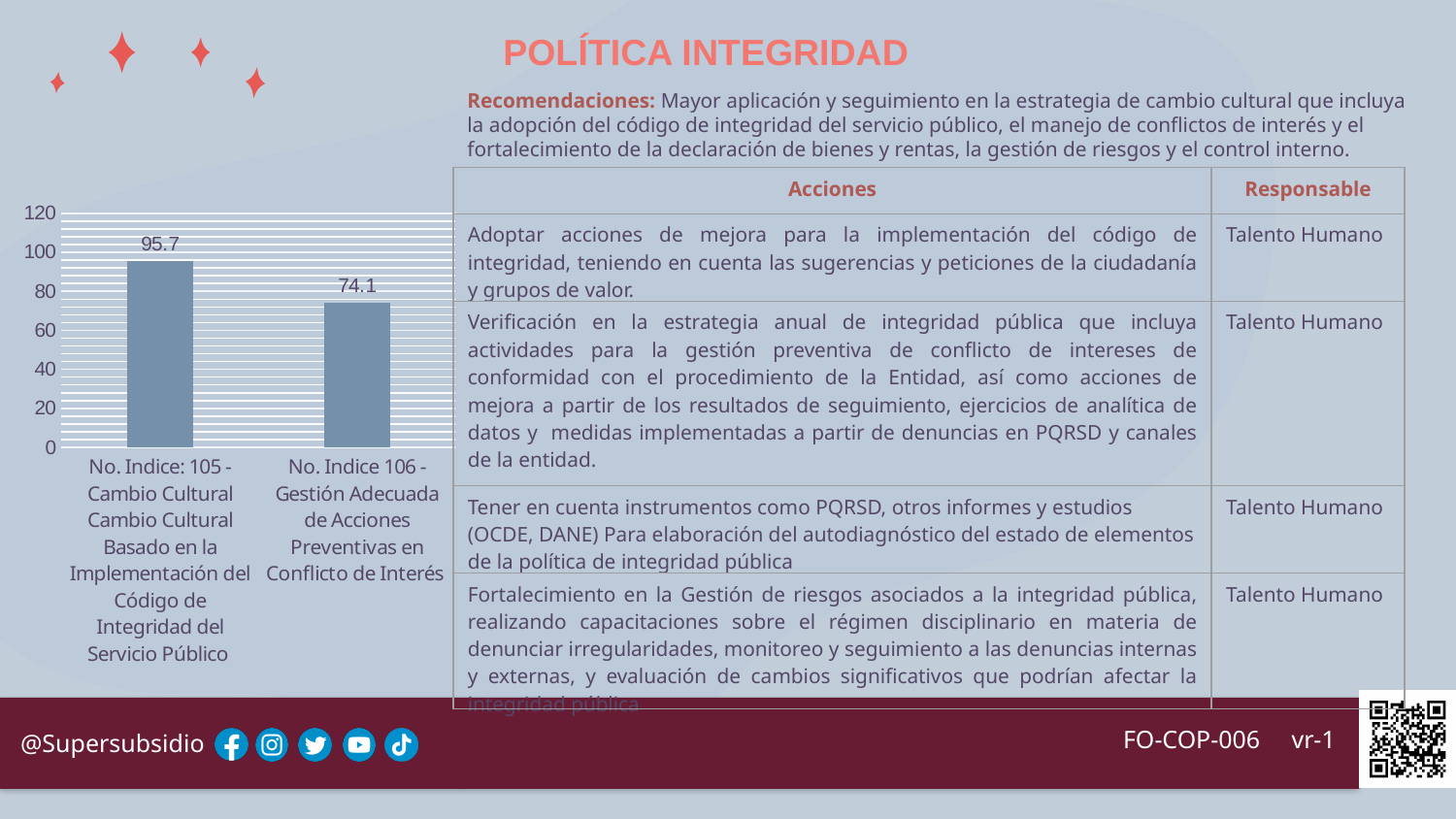
What is the difference between the values for No. Indice: 105 and No. Indice 106? 21.6 Which category has the lowest value? No. Indice 106 - Gestión Adecuada de Acciones Preventivas en Conflicto de Interés Is the value for No. Indice 106 - Gestión Adecuada de Acciones Preventivas en Conflicto de Interés greater or less than 80? less Which category has the highest value? No. Indice: 105 - Cambio Cultural Basado en la Implementación del Código de Integridad del Servicio Público What kind of chart is shown on the slide? bar chart How many categories are shown in the chart? 2 What is the value for No. Indice 106 - Gestión Adecuada de Acciones Preventivas en Conflicto de Interés? 74.1 Is the value for No. Indice: 105 greater or less than 80? greater Which is larger, the value for No. Indice: 105 or the value for No. Indice 106? No. Indice: 105 What is the value for No. Indice: 105 - Cambio Cultural Basado en la Implementación del Código de Integridad del Servicio Público? 95.7 Do the values rise or fall from the first category to the second along the x axis? fall What is the maximum value shown on the chart's vertical axis? 120